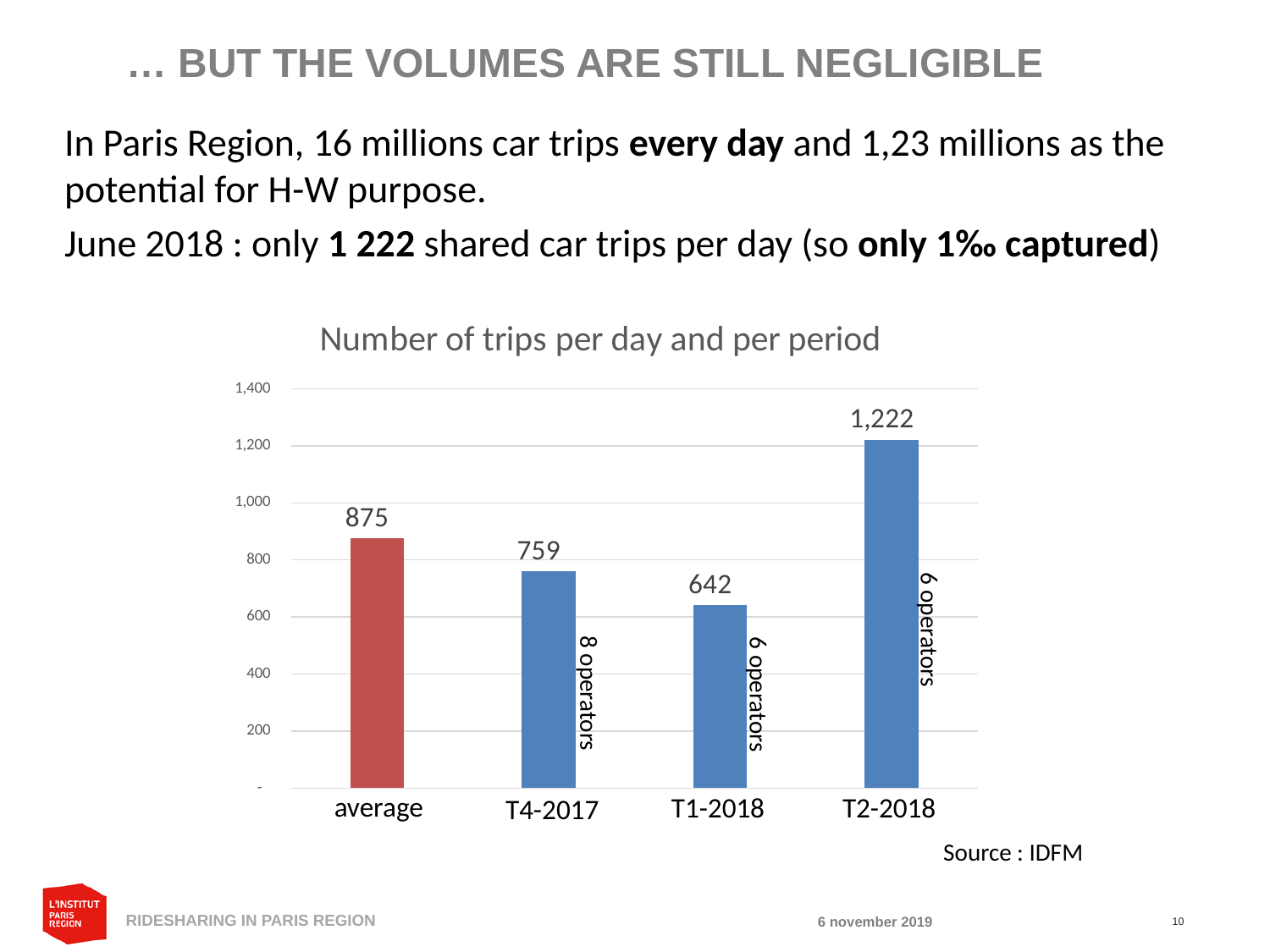
What is the number of trips per day for T2-2018? 1,222 What is the value shown for the average bar? 875 Which period has the highest number of trips per day? T2-2018 Which category has the lowest value in the chart? T1-2018 What kind of chart is shown on the slide? bar chart What is the difference between the average value and the T4-2017 value? 116 What is the number of trips per day for T4-2017? 759 Is the value for T2-2018 greater or less than 1,000? greater What is the title of the chart? Number of trips per day and per period How many bars are shown in the chart? 4 What is the difference between the T2-2018 value and the T1-2018 value? 580 Which is larger, the value for T4-2017 or the value for T1-2018? T4-2017